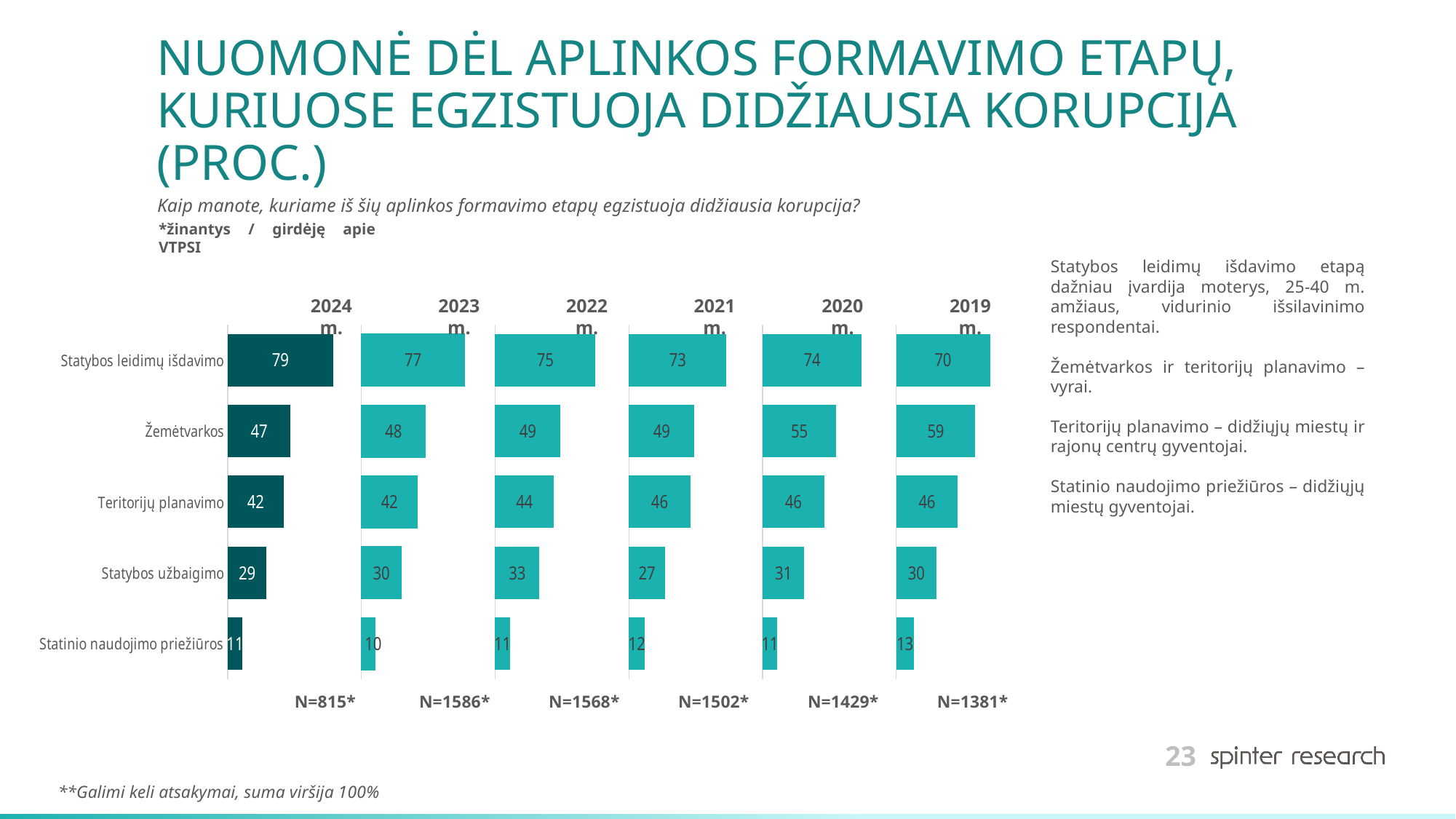
Reading from 2019 m. to 2024 m., does the value for Žemėtvarkos rise or fall? Fall In the 2022 m. chart, which category has the highest value? Statybos leidimų išdavimo In the 2024 m. chart, what is the value for Statybos leidimų išdavimo? 79 In the 2019 m. chart, what is the value for Žemėtvarkos? 59 What is the difference between the Statybos leidimų išdavimo values in the 2024 m. chart and the 2019 m. chart? 9 What is the sample size (N) shown under the 2023 m. chart? N=1586* In the 2020 m. chart, which category has the lowest value? Statinio naudojimo priežiūros How many categories are shown in each year's chart? 5 Which is larger: Žemėtvarkos in the 2020 m. chart or Žemėtvarkos in the 2021 m. chart? 2020 m. In the 2023 m. chart, what is the difference between Žemėtvarkos and Teritorijų planavimo? 6 What kind of chart is used on this slide? Bar chart In the 2021 m. chart, what is the value for Statybos užbaigimo? 27